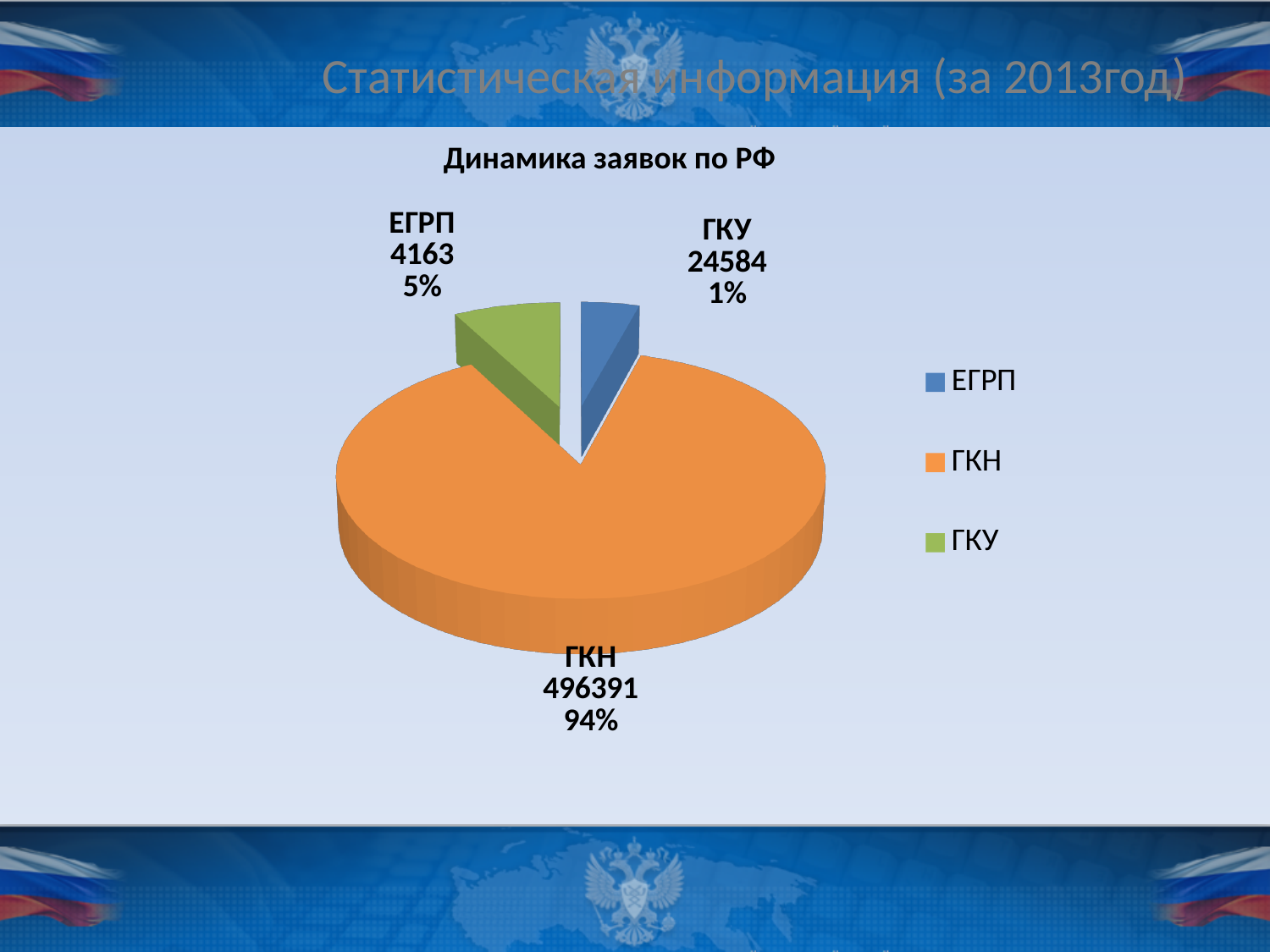
What is the title of the chart? Динамика заявок по РФ What is the difference between the values for ГКН and ГКУ? 471807 How many categories does the pie chart have? 3 How many entries does the legend list? 3 What percentage share of the pie is labelled for ГКН? 94% Which category has the lowest value? ЕГРП What is the value shown for ГКН? 496391 What is the value shown for ЕГРП? 4163 Which is larger, the value for ГКУ or the value for ЕГРП? ГКУ Which category has the highest value? ГКН What type of chart is shown on the slide? pie chart What is the value shown for ГКУ? 24584